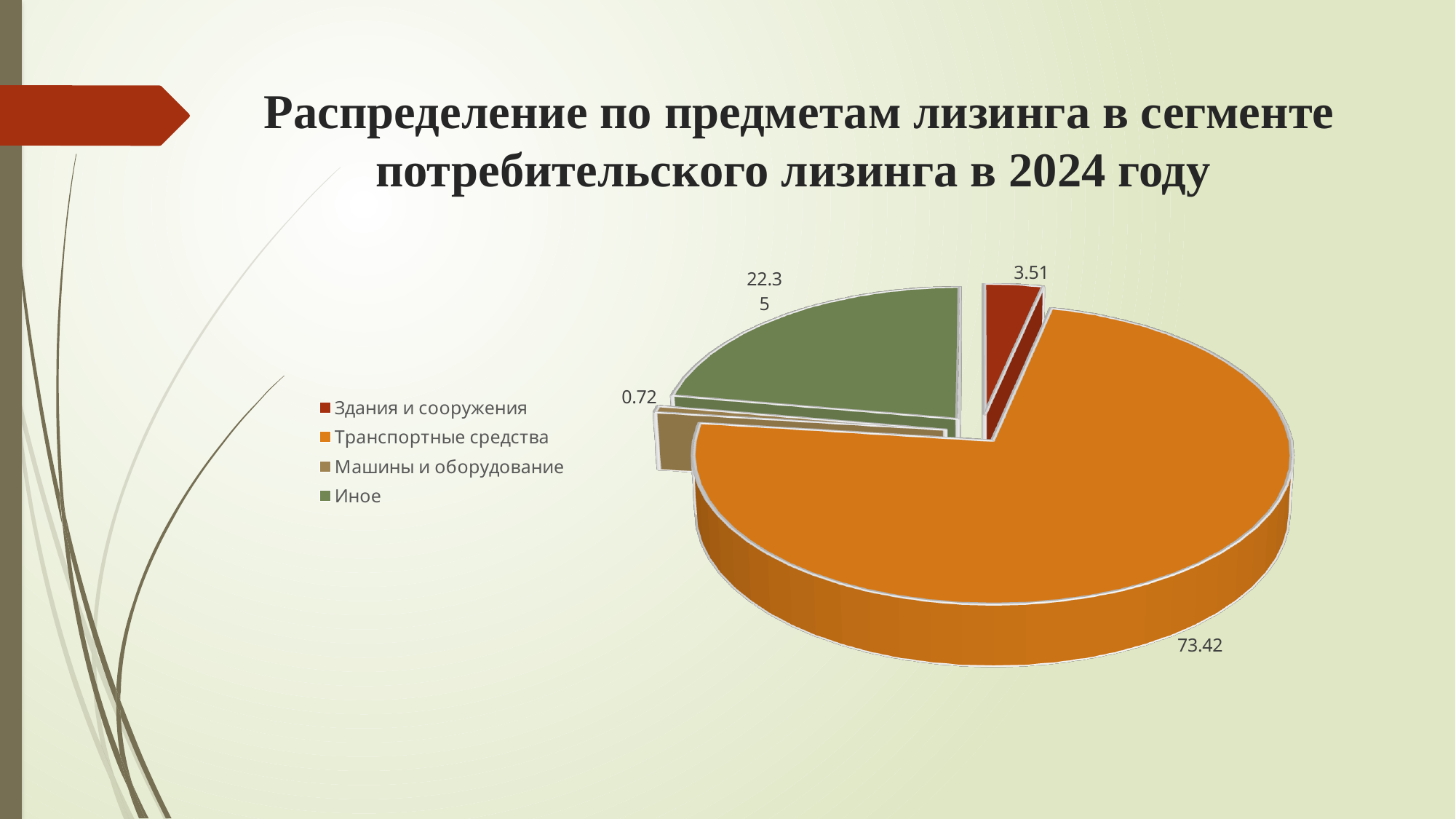
What colour is the slice for Иное? Green What is the difference between the values for Иное and Здания и сооружения? 18.84 What is the value shown for Здания и сооружения? 3.51 What is the value shown for Машины и оборудование? 0.72 What type of chart is shown on the slide? Pie chart What is the value shown for Транспортные средства? 73.42 How many categories does the pie chart contain? 4 Which category has the largest slice of the pie? Транспортные средства Which category has the smallest slice of the pie? Машины и оборудование What is the value shown for Иное? 22.35 Which is larger, the value for Здания и сооружения or the value for Машины и оборудование? Здания и сооружения What is the difference between the values for Транспортные средства and Иное? 51.07